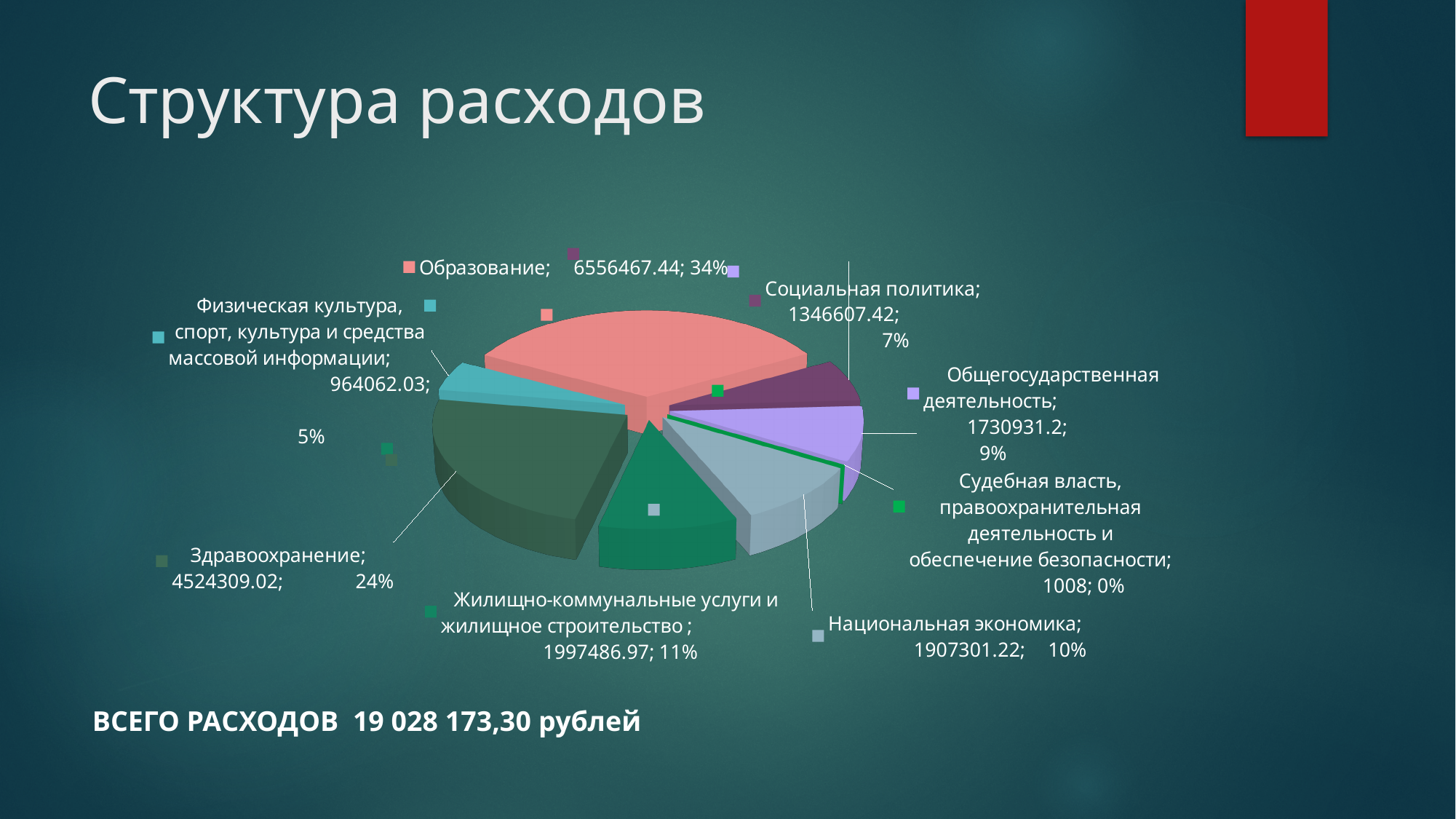
What share of the pie does Социальная политика represent? 7% What is the value for Физическая культура, спорт, культура и средства массовой информации? 964062.03 Which category has the largest share of the pie? Образование Which category has the smallest share of the pie? Судебная власть, правоохранительная деятельность и обеспечение безопасности What kind of chart is shown on the slide? pie chart Which is larger: the value for Жилищно-коммунальные услуги и жилищное строительство or the value for Общегосударственная деятельность? Жилищно-коммунальные услуги и жилищное строительство What is the value for Образование? 6556467.44 What is the title of the chart? Структура расходов What is the difference in percentage share between Образование and Здравоохранение? 10% What share of the pie does Здравоохранение represent? 24% How many categories (slices) does the pie chart have? 8 What is the value for Национальная экономика? 1907301.22